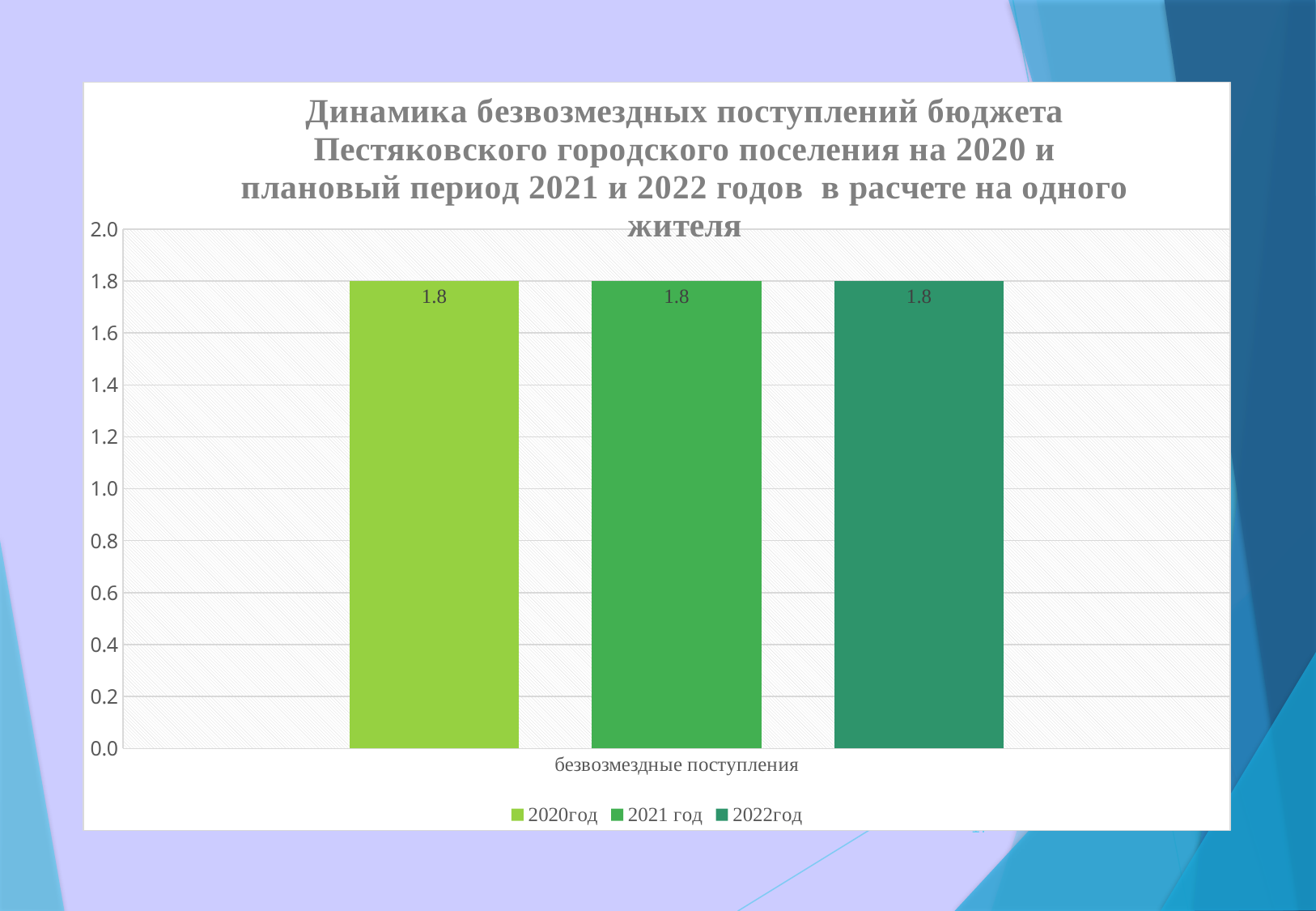
What is the value for the 2020год series in the chart? 1.8 What is the category label shown on the x axis? безвозмездные поступления Do the values rise, fall, or stay the same from 2020год to 2022год? stay the same Is the value for 2021 год greater or less than 1.0? greater What is the difference between the 2020год and 2022год values? 0.0 What kind of chart is shown on the slide? bar chart What is the highest value shown on the y axis? 2.0 What is the value for the 2021 год series in the chart? 1.8 How many bars are plotted in the chart? 3 How many series does the legend list? 3 Is the value for 2022год greater or less than 2.0? less What is the value for the 2022год series in the chart? 1.8